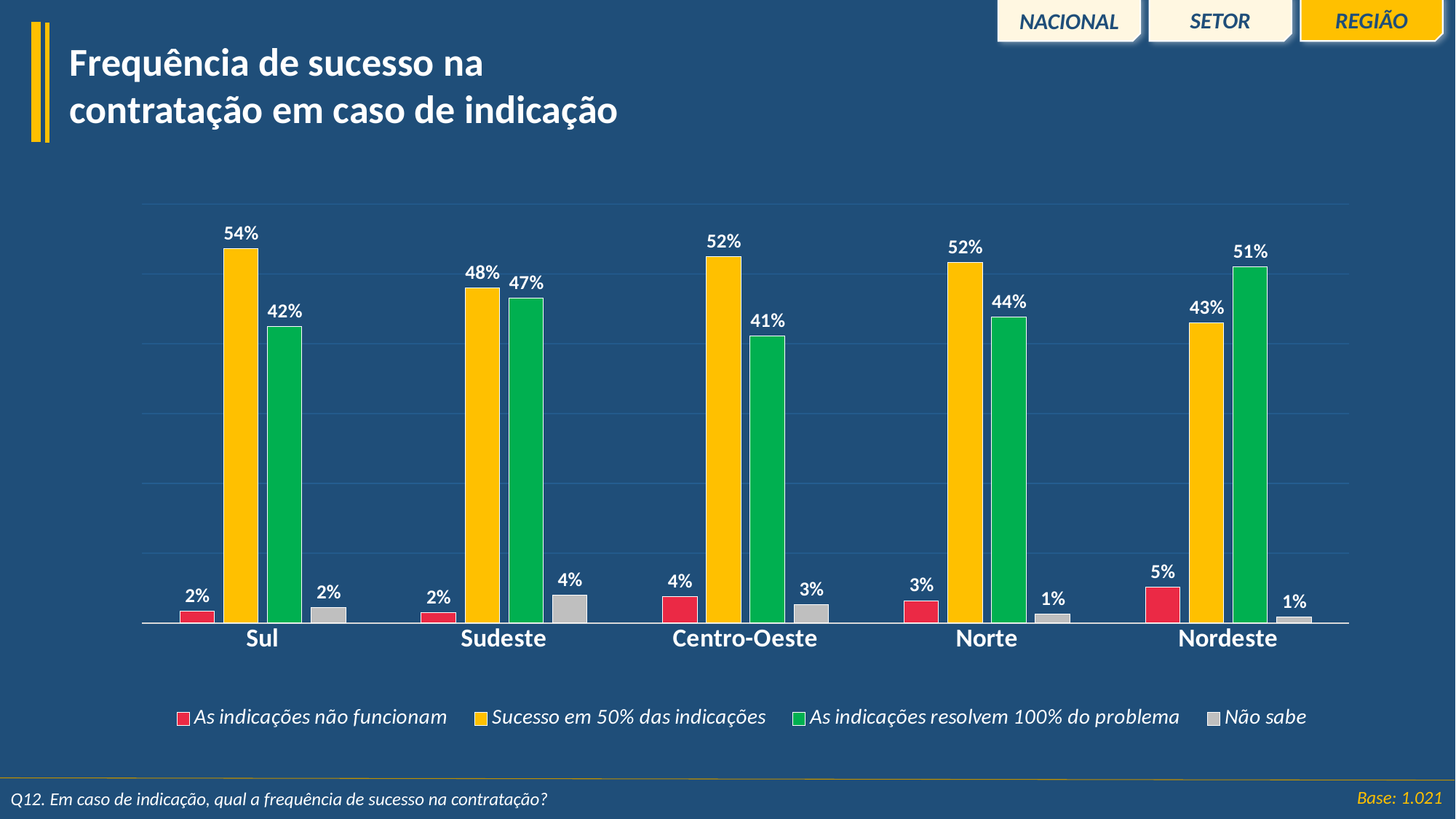
Which region has the highest value for 'Sucesso em 50% das indicações'? Sul Which region has the lowest value for 'As indicações resolvem 100% do problema'? Centro-Oeste How many series does the legend list? 4 What is the difference between 'Sucesso em 50% das indicações' and 'As indicações resolvem 100% do problema' in the Sul region? 12% Which colour represents 'Não sabe' in the legend? Grey How many regions are shown on the x axis? 5 What kind of chart is shown on the slide? Bar chart What is the value for 'As indicações resolvem 100% do problema' in the Nordeste region? 51% What is the value for 'Sucesso em 50% das indicações' in the Sul region? 54% What is the value for 'Não sabe' in the Sudeste region? 4% What is the value for 'As indicações não funcionam' in the Centro-Oeste region? 4% In the Nordeste region, which is larger: 'Sucesso em 50% das indicações' or 'As indicações resolvem 100% do problema'? As indicações resolvem 100% do problema